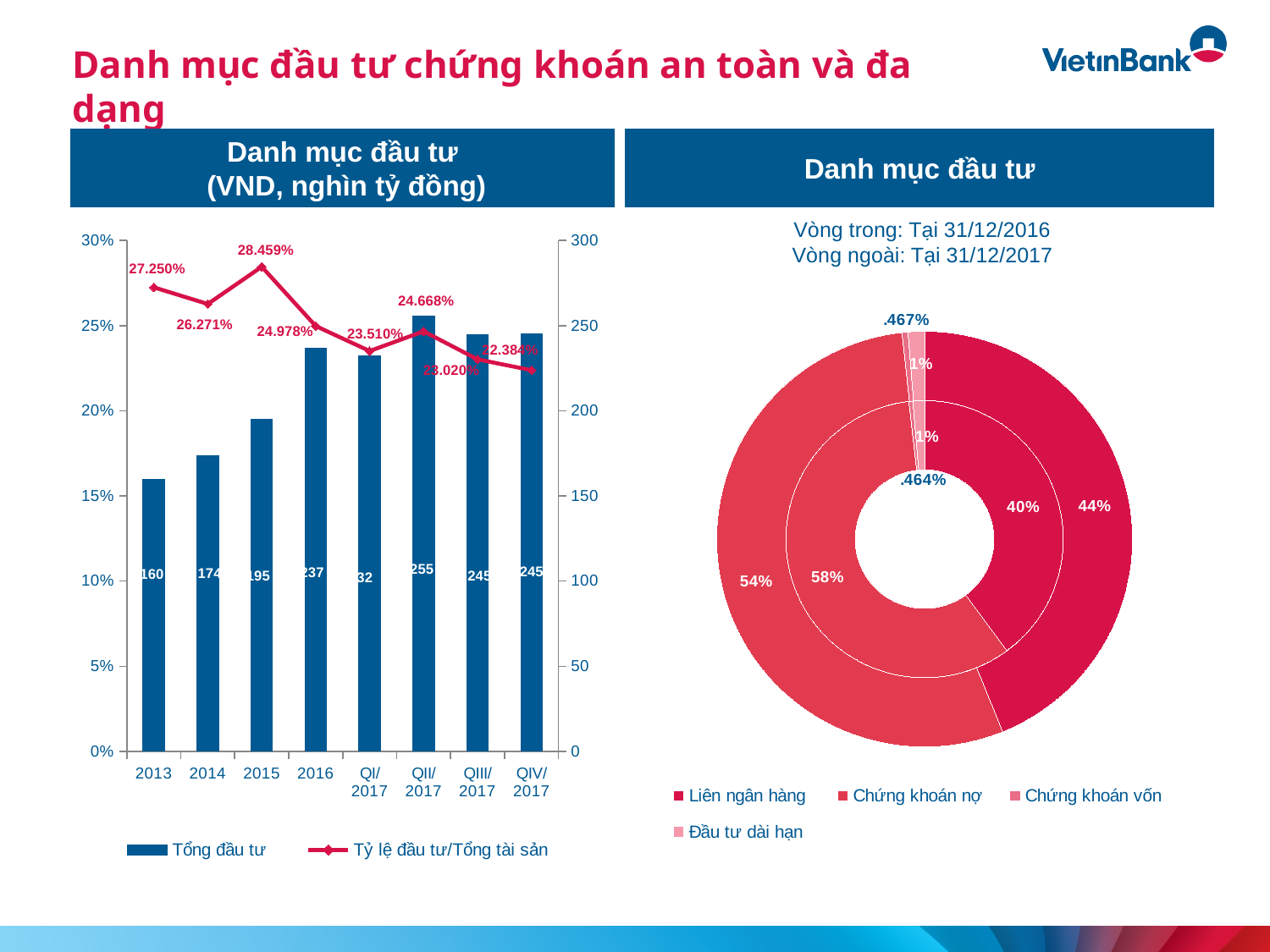
In the doughnut chart 'Danh mục đầu tư' on the right, how many categories does the legend list? 4 In the chart 'Danh mục đầu tư (VND, nghìn tỷ đồng)', what is the value of Tổng đầu tư for 2016? 237 What kind of chart is the left chart 'Danh mục đầu tư (VND, nghìn tỷ đồng)'? Combined bar and line chart In the chart 'Danh mục đầu tư (VND, nghìn tỷ đồng)', which is larger, Tổng đầu tư in 2014 or in 2015? 2015 In the chart 'Danh mục đầu tư (VND, nghìn tỷ đồng)', what is the difference in Tổng đầu tư between 2016 and 2015? 42 In the chart 'Danh mục đầu tư (VND, nghìn tỷ đồng)', which period has the lowest Tổng đầu tư? 2013 In the chart 'Danh mục đầu tư (VND, nghìn tỷ đồng)', which period has the highest Tổng đầu tư? QII/2017 In the doughnut chart 'Danh mục đầu tư' on the right, what is the largest share in the outer ring (31/12/2017)? 54% In the chart 'Danh mục đầu tư (VND, nghìn tỷ đồng)', which period has the lowest Tỷ lệ đầu tư/Tổng tài sản? QIV/2017 In the chart 'Danh mục đầu tư (VND, nghìn tỷ đồng)', how many periods are shown on the x axis? 8 In the chart 'Danh mục đầu tư (VND, nghìn tỷ đồng)', what is the Tỷ lệ đầu tư/Tổng tài sản for 2015? 28.459% In the chart 'Danh mục đầu tư (VND, nghìn tỷ đồng)', how many series does the legend list? 2